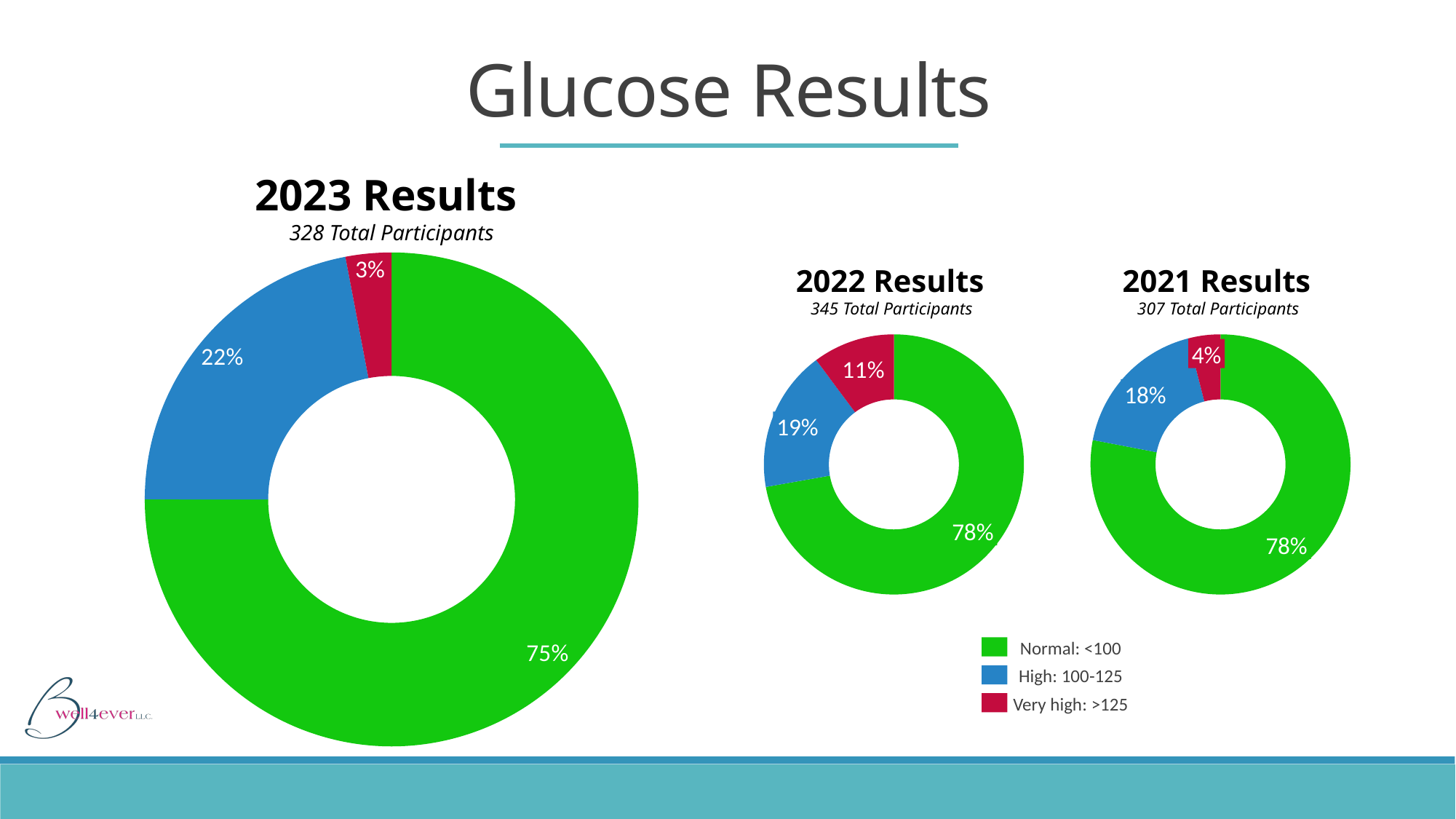
In the 2023 Results chart, which category has the smallest share? Very high: >125 Which is larger: the Very high share in the 2022 Results chart or the Very high share in the 2021 Results chart? 2022 Results In the 2023 Results chart, what is the difference between the Normal and High shares? 53% In the 2023 Results chart, what percentage of participants had Normal (<100) glucose? 75% In the 2022 Results chart, what percentage of participants had Very high (>125) glucose? 11% How many total participants are shown for the 2022 Results chart? 345 Total Participants What kind of chart is used for the 2023 Results? Donut (pie) chart In the 2021 Results chart, what percentage of participants had High (100-125) glucose? 18% How many entries does the legend list? 3 How many categories does each donut chart show? 3 In the 2022 Results chart, which category has the largest share? Normal: <100 In the 2023 Results chart, what percentage of participants had High (100-125) glucose? 22%